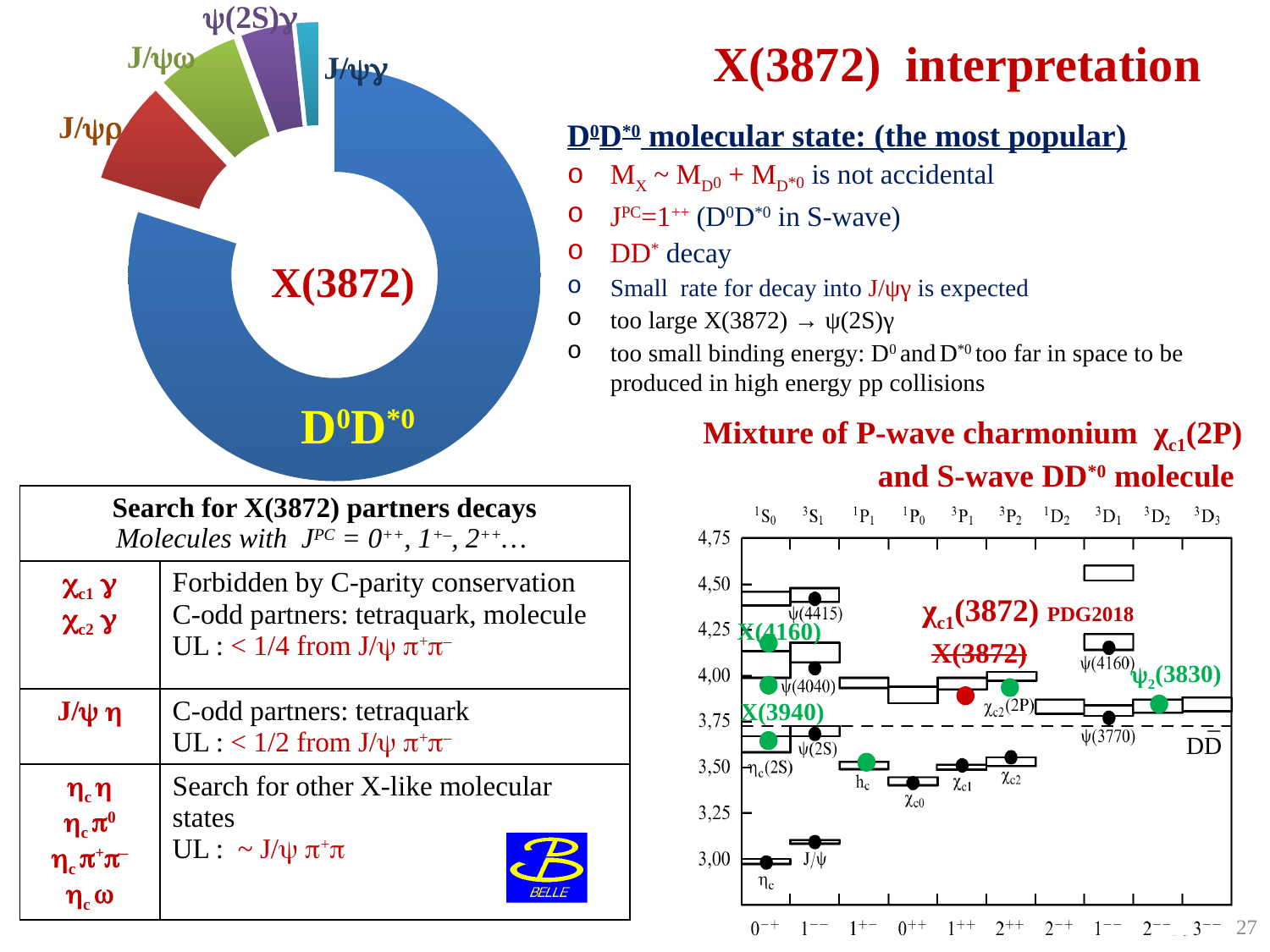
In the doughnut chart in the top-left, which slice is larger: J/ψρ or J/ψω? J/ψρ In the doughnut chart in the top-left, which decay mode has the smallest slice? J/ψγ In the doughnut chart in the top-left, which decay mode has the largest slice? D0D*0 What kind of chart is shown in the top-left of the slide? doughnut chart What label is written in the centre of the doughnut chart in the top-left? X(3872) In the doughnut chart in the top-left, how many slices (decay modes) are shown? 5 In the doughnut chart in the top-left, which slice is larger: D0D*0 or J/ψρ? D0D*0 In the doughnut chart in the top-left, which slice is larger: J/ψω or J/ψγ? J/ψω In the doughnut chart in the top-left, what colour is the D0D*0 slice? blue